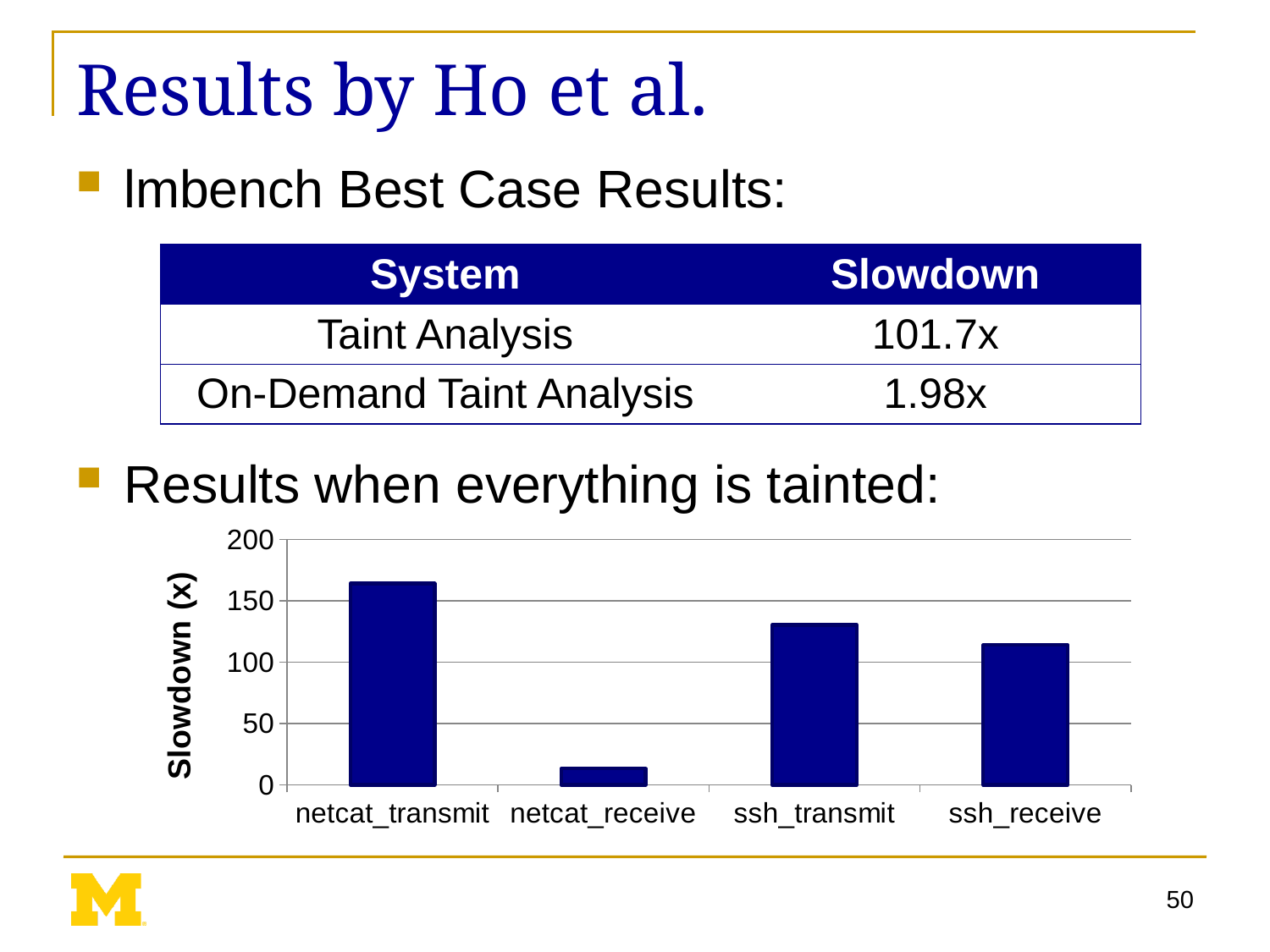
Is the slowdown for netcat_receive greater or less than 50? less What kind of chart is shown on the slide? bar chart Which has a larger slowdown, ssh_transmit or ssh_receive? ssh_transmit Which category has the lowest slowdown in the chart? netcat_receive How many categories are plotted on the x axis of the chart? 4 Is the slowdown for netcat_transmit greater or less than 150? greater Is the slowdown for ssh_transmit greater or less than 100? greater Which category has the highest slowdown in the chart? netcat_transmit What is the maximum value shown on the y axis of the chart? 200 Which has a larger slowdown, netcat_receive or ssh_receive? ssh_receive What is the label of the y axis of the chart? Slowdown (x)